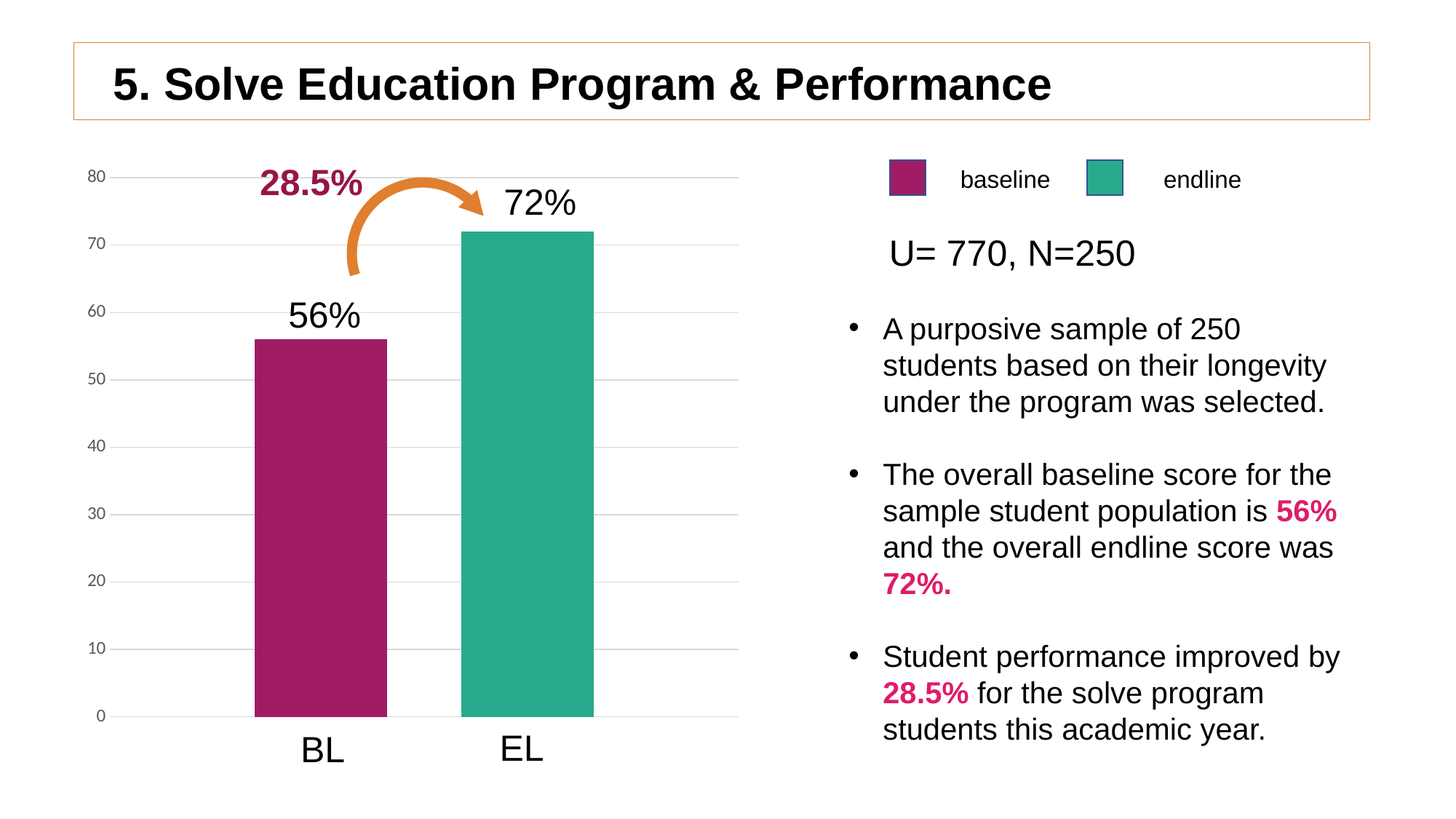
What kind of chart is shown on the slide? bar chart Is the value for EL greater or less than 70? greater Is the value for BL greater or less than 60? less Which is larger, the value for BL or the value for EL? EL What is the difference between the EL value and the BL value? 16% What is the value for EL? 72% Which category has the highest value? EL What is the value for BL? 56% What percentage improvement is labelled on the arrow between the two bars? 28.5% Do the values rise or fall from BL to EL? rise How many categories are shown on the x axis? 2 Which category has the lowest value? BL